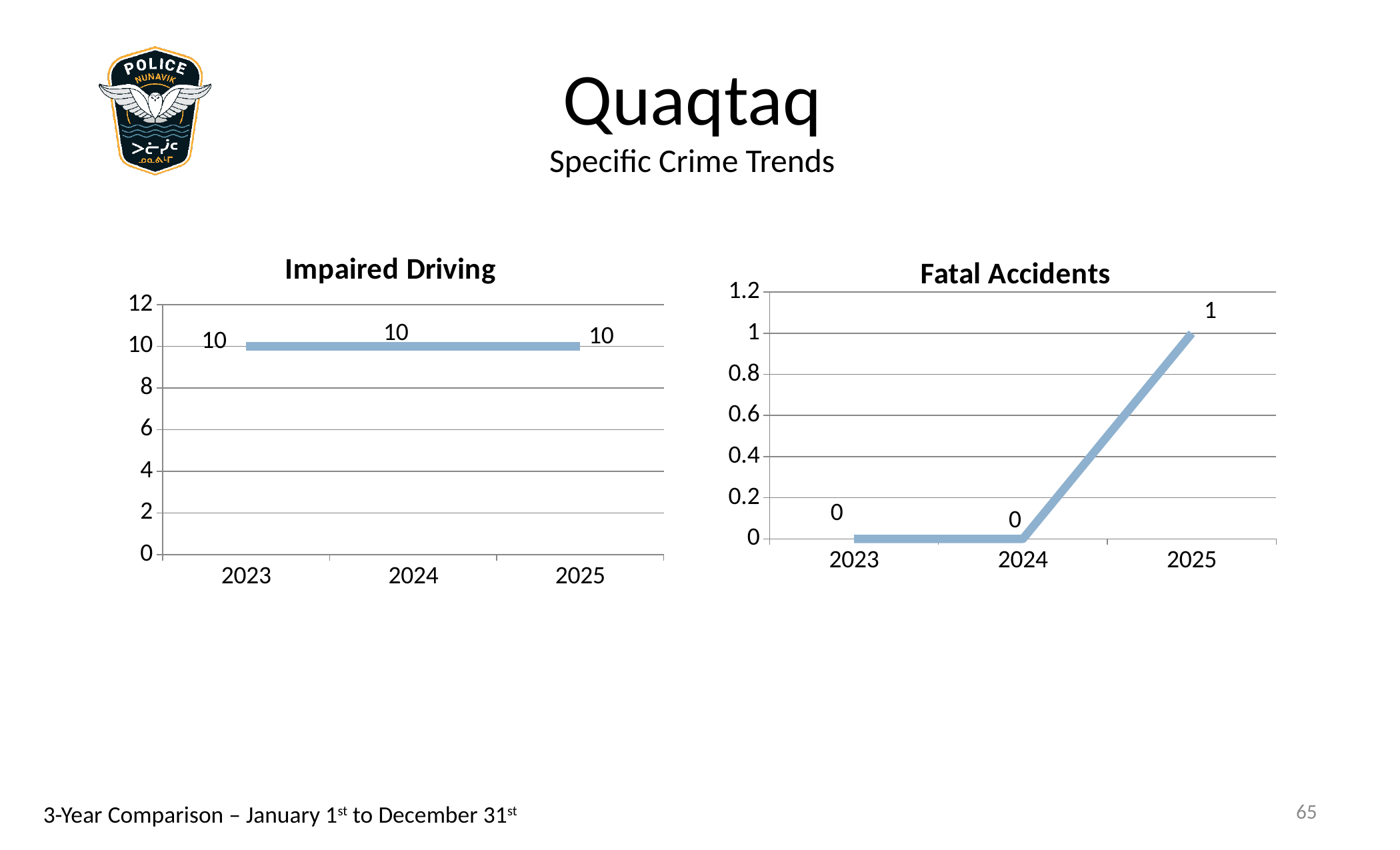
In the Impaired Driving chart, what is the value for 2024? 10 In the Impaired Driving chart, what is the value for 2025? 10 In the Fatal Accidents chart, is the value for 2025 larger than the value for 2024? Yes How many years are plotted in the Impaired Driving chart? 3 What kind of chart is the Fatal Accidents chart? Line chart In the Fatal Accidents chart, what is the value for 2023? 0 What is the title of the chart on the right side of the slide? Fatal Accidents In the Impaired Driving chart, is the value for 2023 greater or less than 8? greater In the Fatal Accidents chart, what is the difference between the 2025 value and the 2024 value? 1 In the Fatal Accidents chart, what is the value for 2025? 1 In the Impaired Driving chart, do the values rise, fall, or stay flat from 2023 to 2025? Stay flat In the Fatal Accidents chart, which year has the highest value? 2025